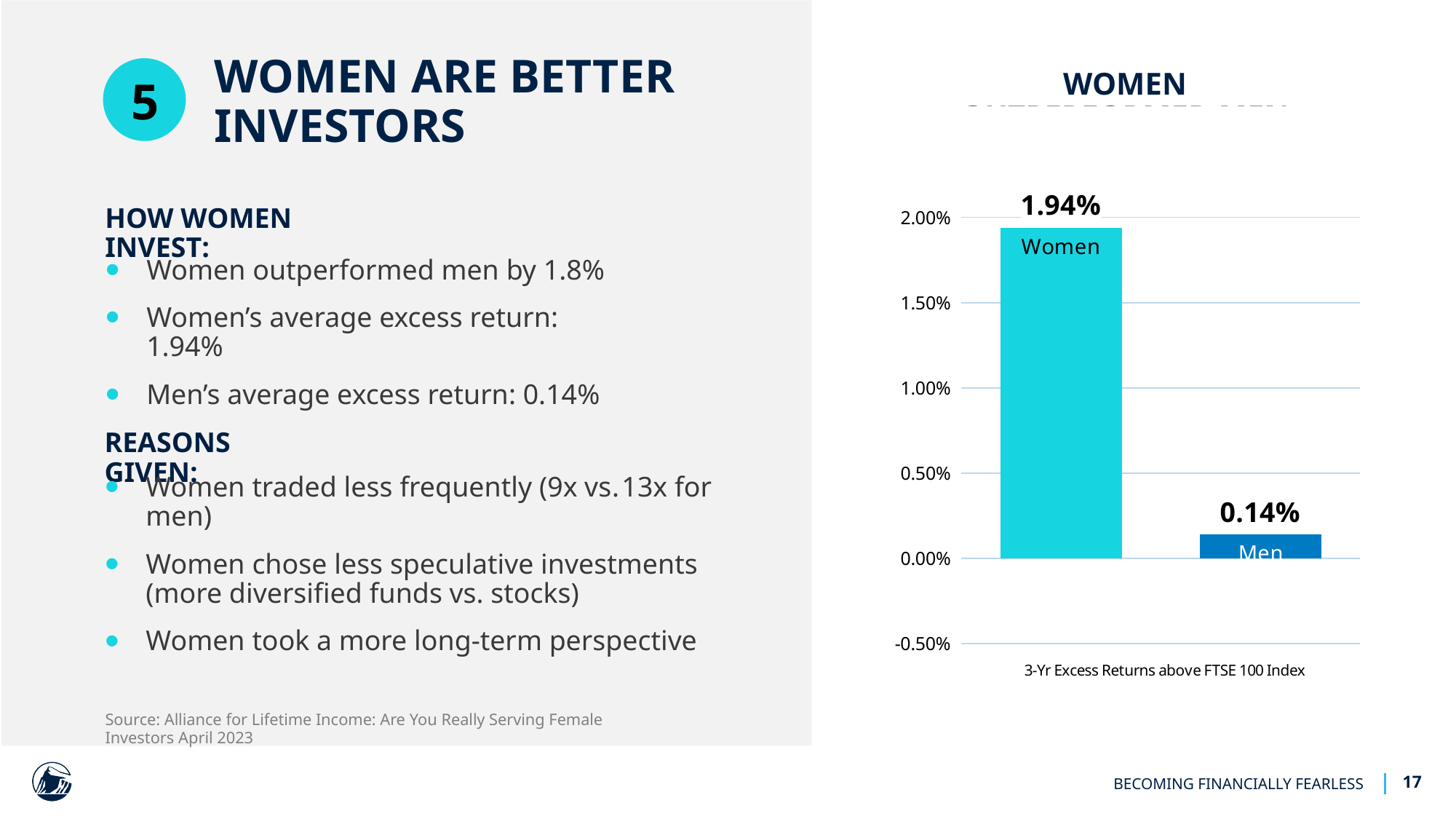
What is the difference between the values for Women and Men in the chart? 1.80% What kind of chart is shown on the slide? bar chart What is the value for Women in the chart? 1.94% Is the value for Women greater or less than 1.50%? greater What is the label shown beneath the chart's x axis? 3-Yr Excess Returns above FTSE 100 Index What is the lowest value shown on the chart's y axis? -0.50% Which category has the highest value in the chart? Women Is the value for Men greater or less than 0.50%? less How many bars are plotted in the chart? 2 Which category has the lowest value in the chart? Men What is the value for Men in the chart? 0.14% Which is larger in the chart, the value for Women or the value for Men? Women